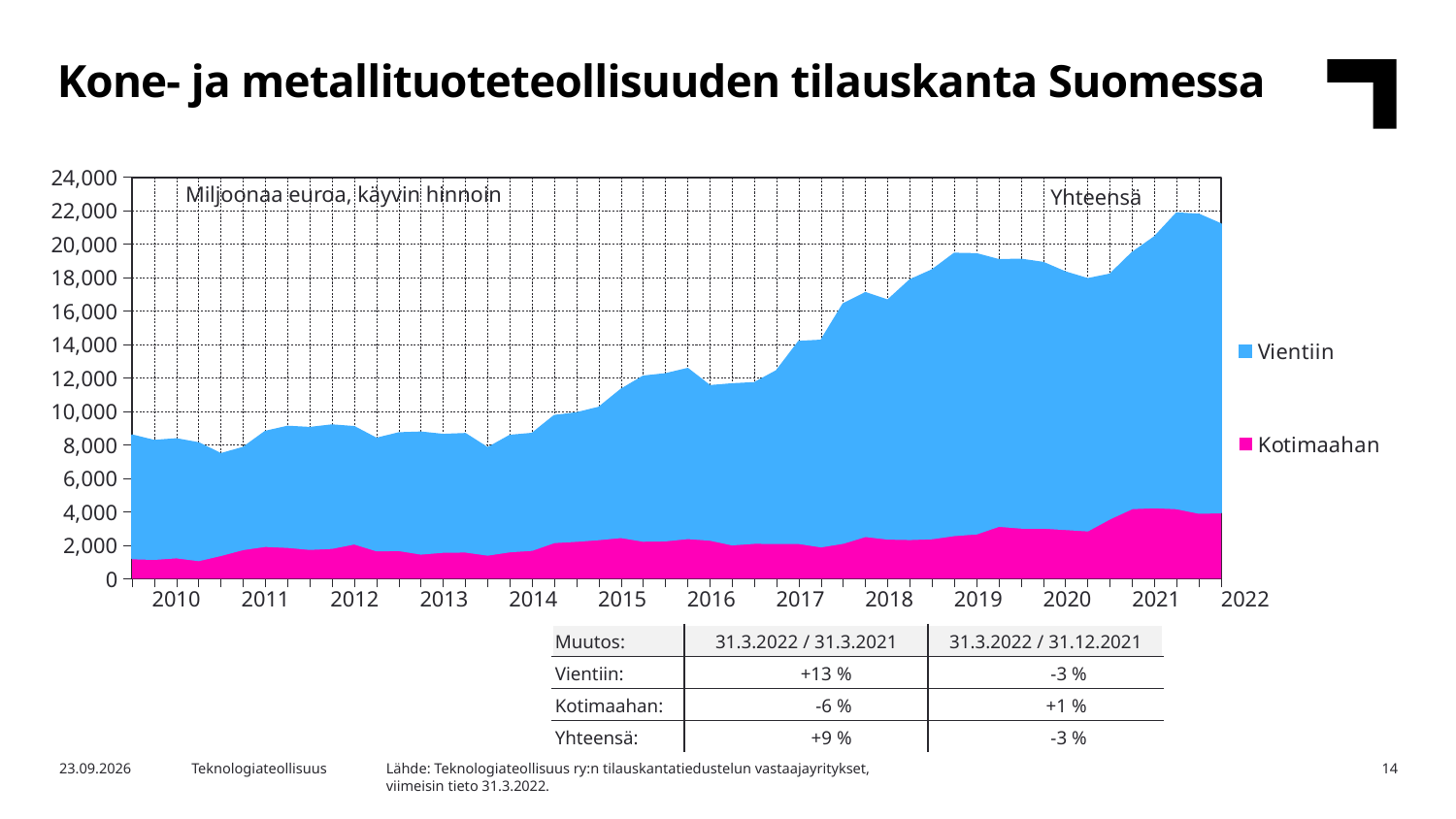
Which series is larger throughout the chart, Vientiin or Kotimaahan? Vientiin What kind of chart is shown on the slide? Stacked area chart Does the total order book generally rise or fall from 2010 to 2022? rise What unit label is printed inside the chart area? Miljoonaa euroa, käyvin hinnoin Is the total (Yhteensä) order book at its peak in 2021 greater or less than 20,000? greater Is the total order book at the start of 2019 greater or less than 18,000? greater In which year does the total order book reach its highest level? 2021 How many series does the chart legend list? 2 What are the two series named in the chart legend? Vientiin and Kotimaahan Is the Kotimaahan value at the start of 2010 greater or less than 2,000? less According to the table, what is the change in Vientiin between 31.3.2021 and 31.3.2022? +13 %